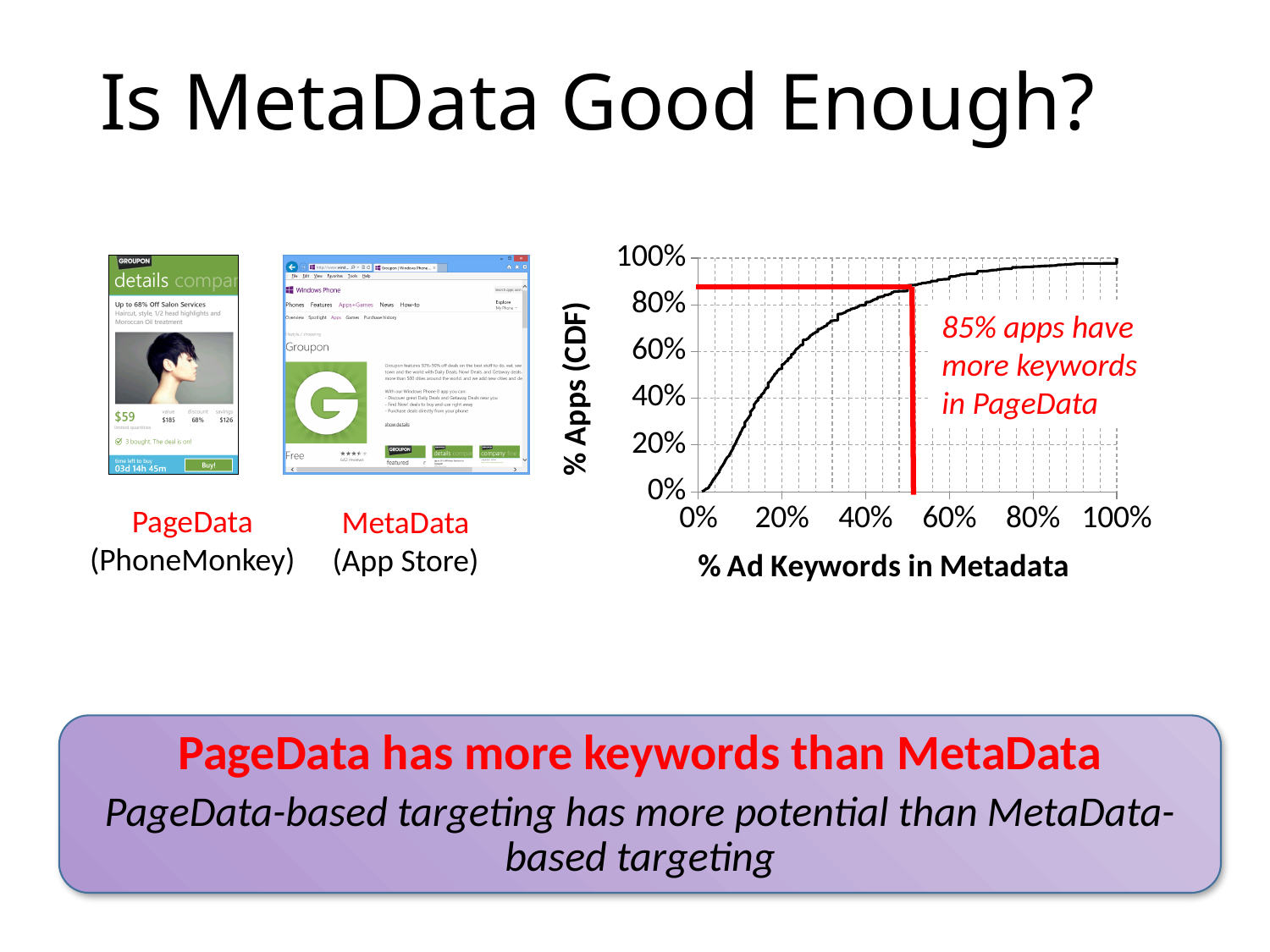
Is the value of the curve at 0% Ad Keywords in Metadata greater or less than 20%? less Is the value of the curve at 10% Ad Keywords in Metadata greater or less than 40%? less Is the value of the curve at 80% Ad Keywords in Metadata greater or less than 80%? greater What is the highest value shown on the y axis of the chart? 100% What is the label of the x axis of the chart? % Ad Keywords in Metadata What kind of chart is shown on the right of the slide? line chart What is the label of the y axis of the chart? % Apps (CDF) According to the annotation on the chart, what percentage of apps have more keywords in PageData? 85% Does the curve in the chart rise or fall as % Ad Keywords in Metadata increases? rise